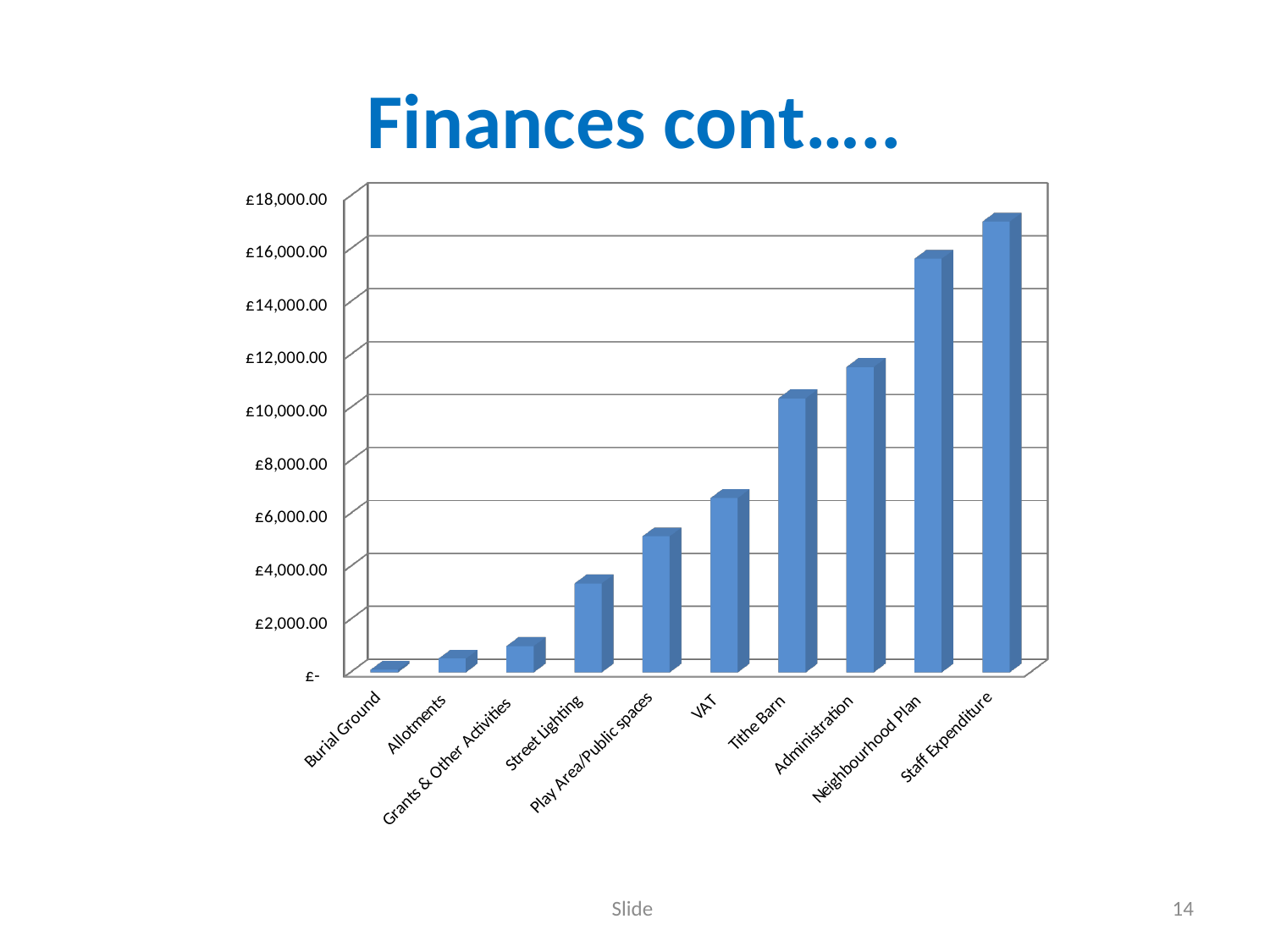
Which category has the lowest value? Burial Ground What kind of chart is shown on the slide? bar chart Is the value for Street Lighting greater or less than £4,000.00? less Do the values rise or fall moving from left to right along the x axis? rise What is the title of the slide containing the chart? Finances cont….. Is the value for Play Area/Public spaces greater or less than £6,000.00? less Is the value for Staff Expenditure greater or less than £16,000.00? greater Which is larger, the value for Tithe Barn or the value for VAT? Tithe Barn Which category has the highest value? Staff Expenditure How many categories are plotted on the chart? 10